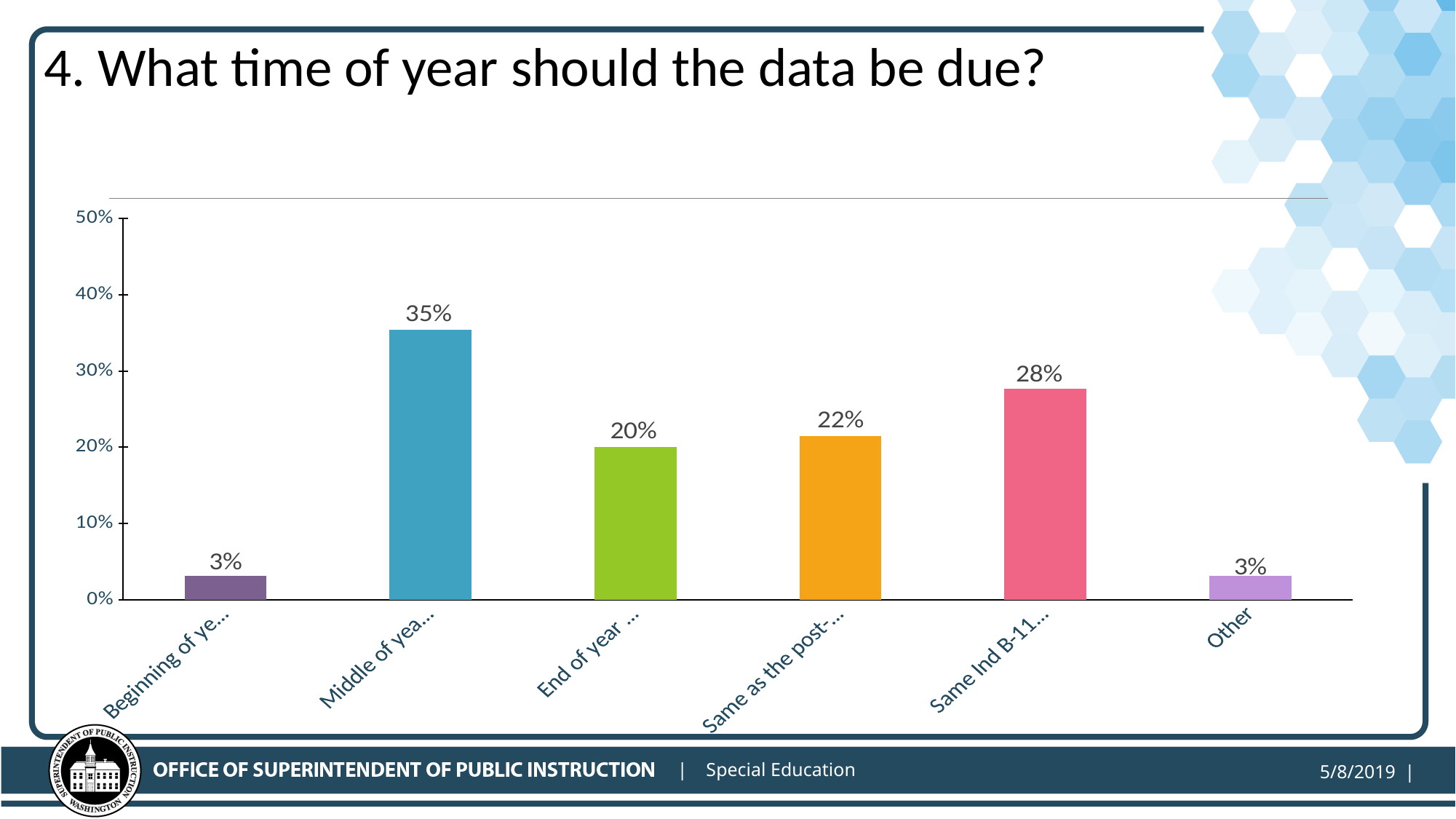
What is the difference between the "Middle of yea..." bar and the "Same Ind B-11..." bar? 7% What kind of chart is shown on the slide? bar chart How many bars are shown on the chart? 6 What is the value of the bar labelled "Same as the post-..."? 22% What is the value of the "Other" bar? 3% What is the lowest value shown on the chart? 3% Is the value for "Same Ind B-11..." greater or less than 30%? less Which is larger, the "End of year ..." bar or the "Same as the post-..." bar? Same as the post-... What is the title of the slide? 4. What time of year should the data be due? Which category has the highest value? Middle of yea... What is the value of the bar labelled "Same Ind B-11..."? 28% What is the value of the bar labelled "Middle of yea..."? 35%